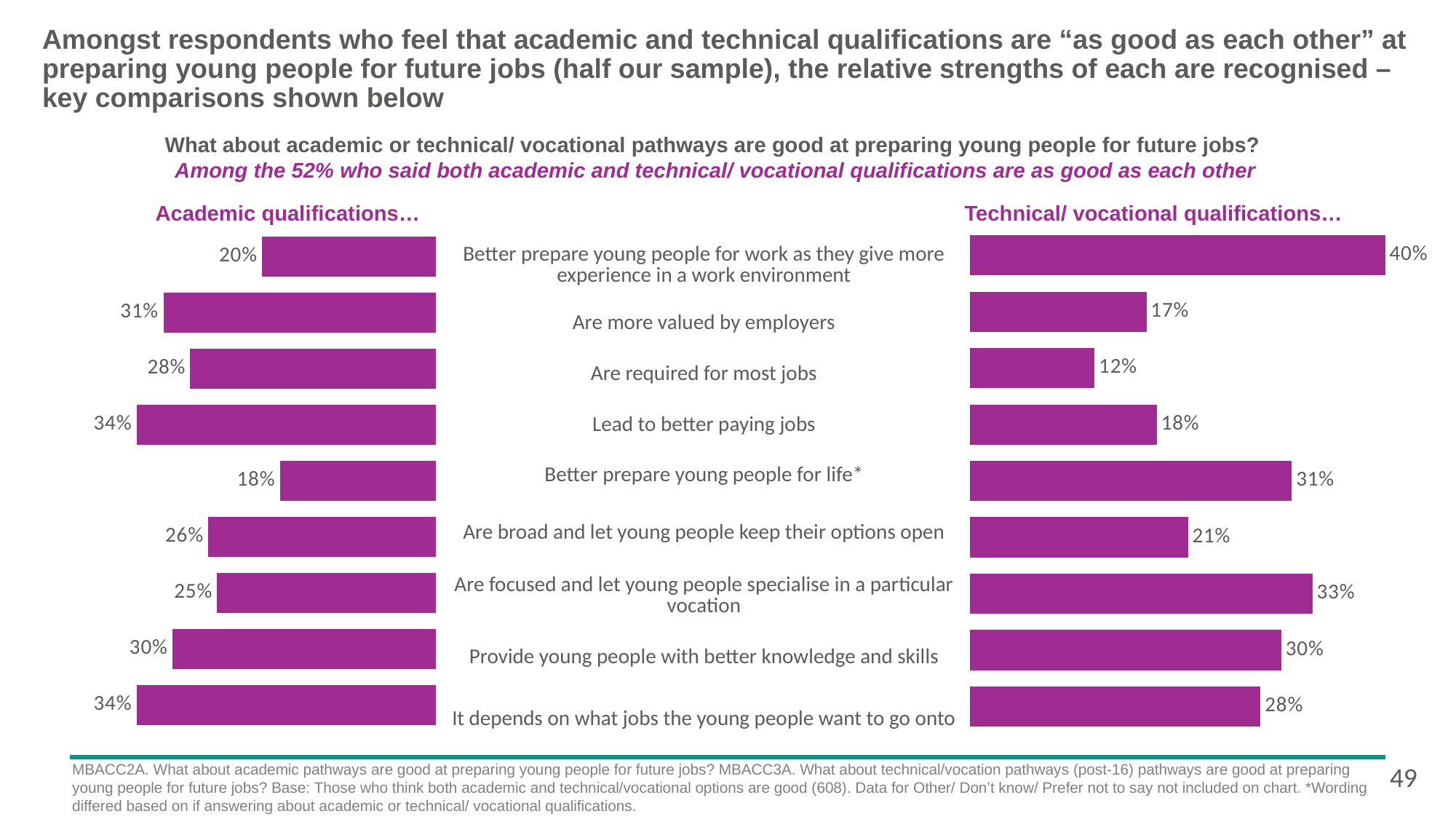
In the Academic qualifications chart, what percentage is shown for "Are focused and let young people specialise in a particular vocation"? 25% In the Technical/ vocational qualifications chart, what percentage is shown for "Better prepare young people for work as they give more experience in a work environment"? 40% In the Technical/ vocational qualifications chart, which category has the highest value? Better prepare young people for work as they give more experience in a work environment For "Better prepare young people for life*", which chart shows the larger value, Academic qualifications or Technical/ vocational qualifications? Technical/ vocational qualifications What is the difference between the Academic and Technical/ vocational values for "Are required for most jobs"? 16% In the Academic qualifications chart, which category has the lowest value? Better prepare young people for life* In the Technical/ vocational qualifications chart, what percentage is shown for "Lead to better paying jobs"? 18% In the Academic qualifications chart, what percentage is shown for "Are more valued by employers"? 31% In the Technical/ vocational qualifications chart, which category has the lowest value? Are required for most jobs What type of chart is used for the Technical/ vocational qualifications data? Bar chart How many categories are shown in the Academic qualifications chart? 9 According to the subtitle, what percentage of respondents said both academic and technical/ vocational qualifications are as good as each other? 52%